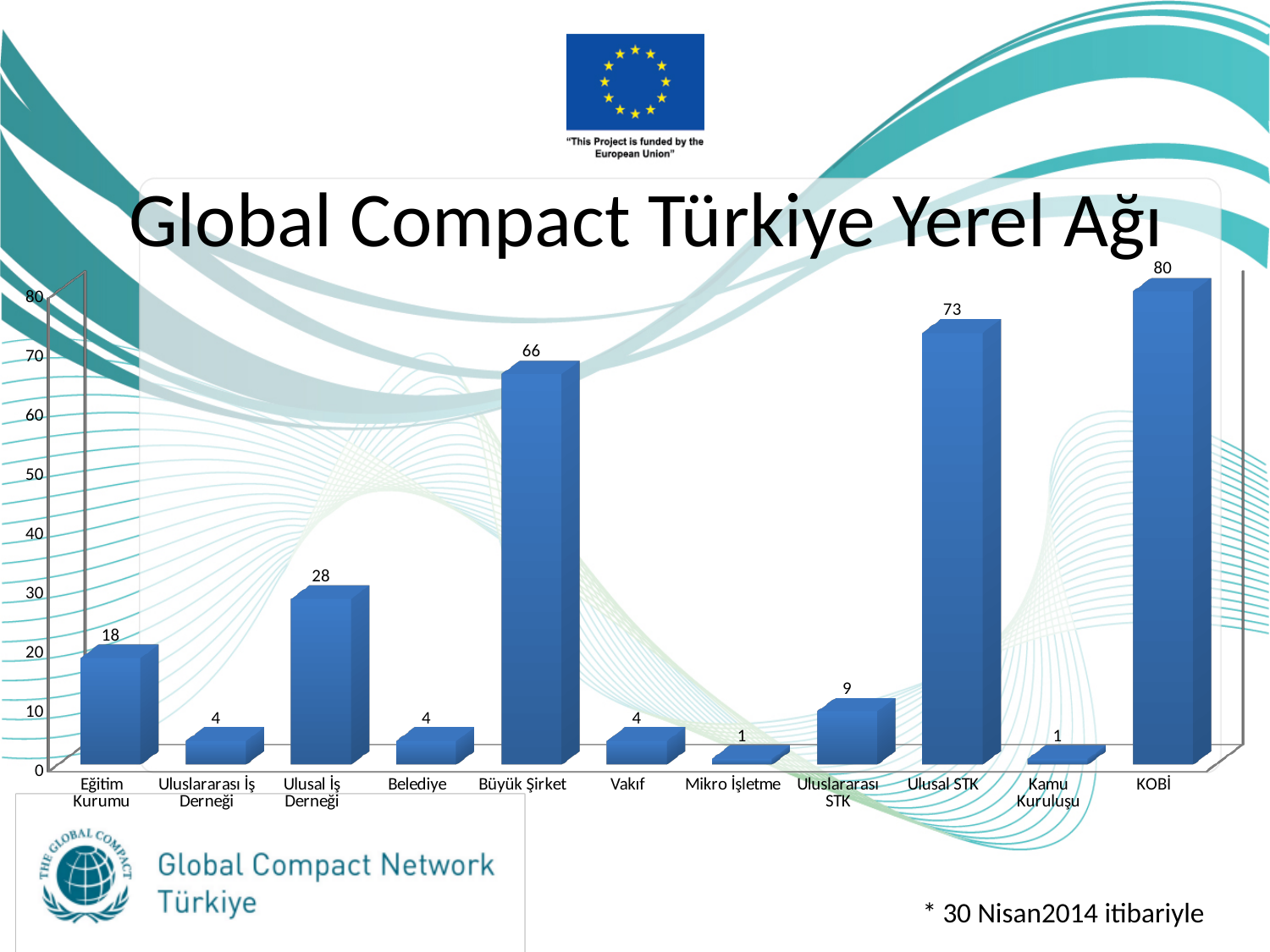
What is the difference between the values for KOBİ and Ulusal STK? 7 Which is larger, the value for Eğitim Kurumu or the value for Uluslararası STK? Eğitim Kurumu What is the title of the chart? Global Compact Türkiye Yerel Ağı What is the value for Kamu Kuruluşu? 1 What is the value for Büyük Şirket? 66 What is the difference between the values for Büyük Şirket and Ulusal İş Derneği? 38 What is the value for Uluslararası STK? 9 What kind of chart is shown on the slide? bar chart How many categories are shown on the x axis? 11 What is the value for Ulusal İş Derneği? 28 Which category has the highest value? KOBİ Is the value for Ulusal STK greater or less than 70? greater